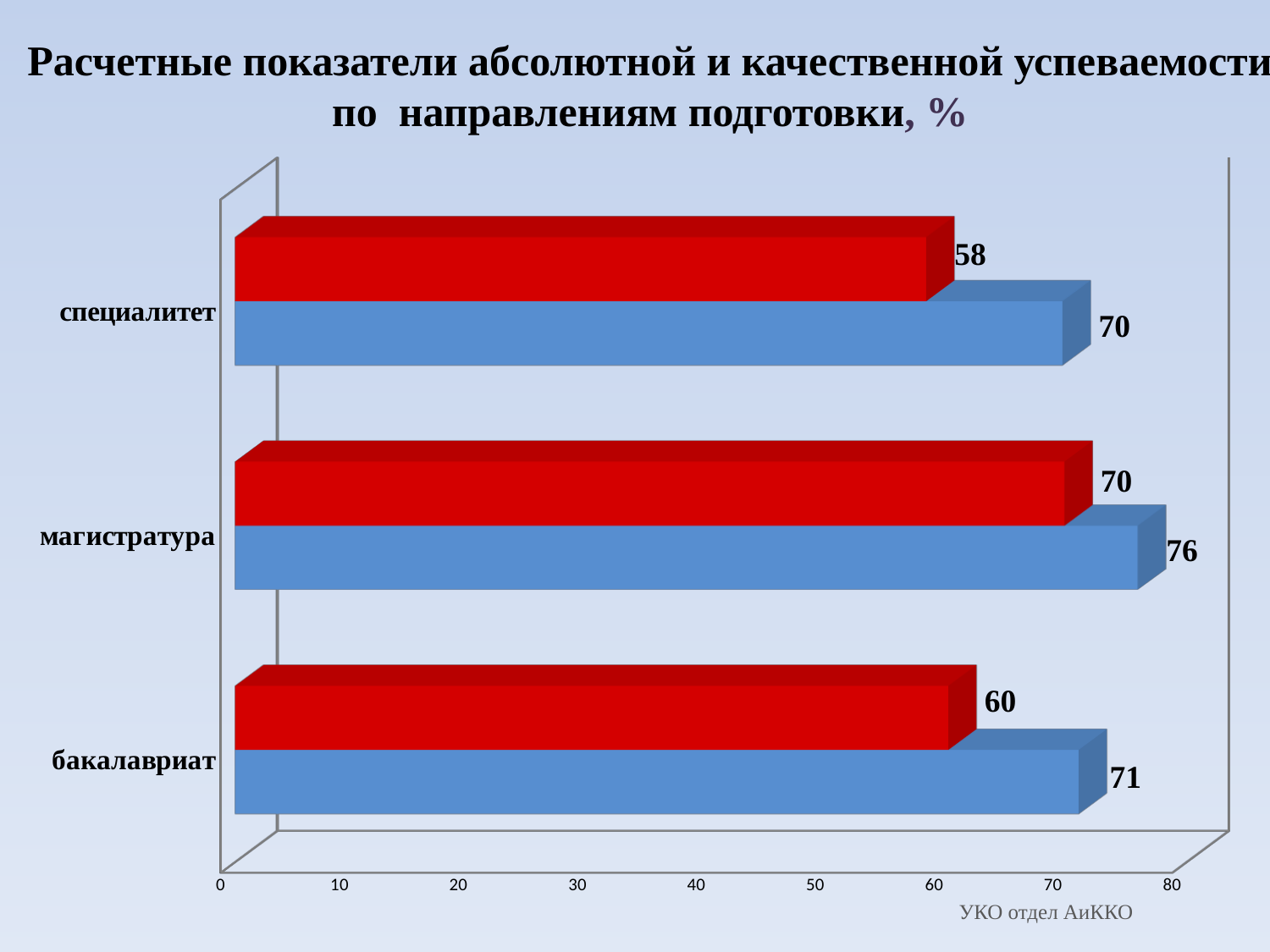
How many categories are shown on the chart? 3 What is the value of the red bar for магистратура? 70 Which is larger: the red bar for бакалавриат or the red bar for специалитет? бакалавриат What is the value of the blue bar for бакалавриат? 71 What type of chart is shown on the slide? bar chart Which category has the highest blue bar value? магистратура What is the value of the red bar for специалитет? 58 Which category has the lowest red bar value? специалитет What is the difference between the blue and red bar values for специалитет? 12 What unit is indicated in the chart title? % What is the difference between the blue bar values for магистратура and бакалавриат? 5 What is the value of the blue bar for магистратура? 76